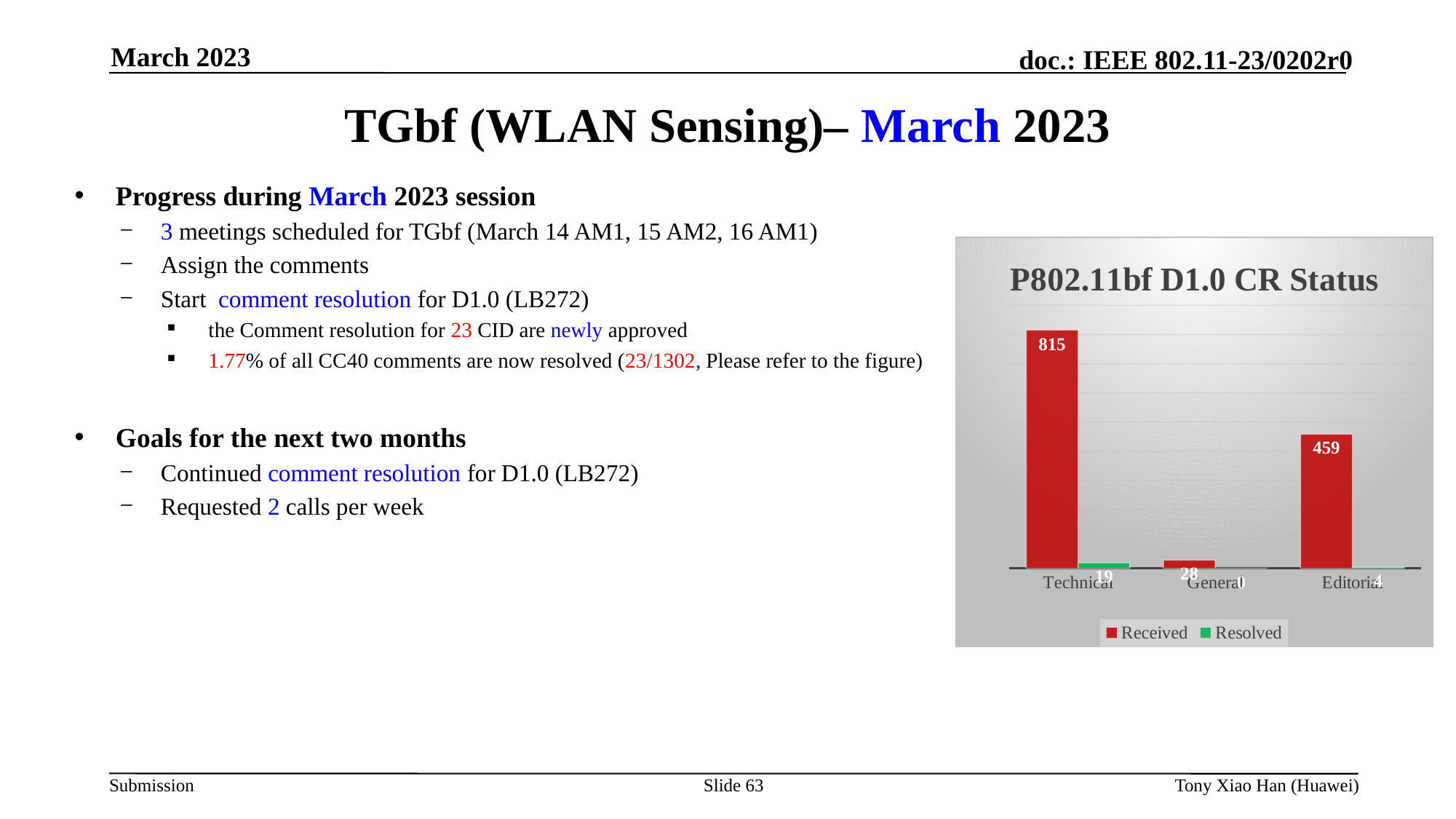
What is the title of the chart? P802.11bf D1.0 CR Status How many categories are shown on the x axis of the chart? 3 Which series is shown in red in the chart? Received What is the Resolved value for Technical? 19 What is the Received value for General? 28 How many series does the chart legend list? 2 What is the difference between the Received values for Technical and Editorial? 356 What is the Received value for Technical? 815 Which category has the highest Received value? Technical What is the Received value for Editorial? 459 Which category has the lowest Received value? General What kind of chart is shown on the slide? bar chart